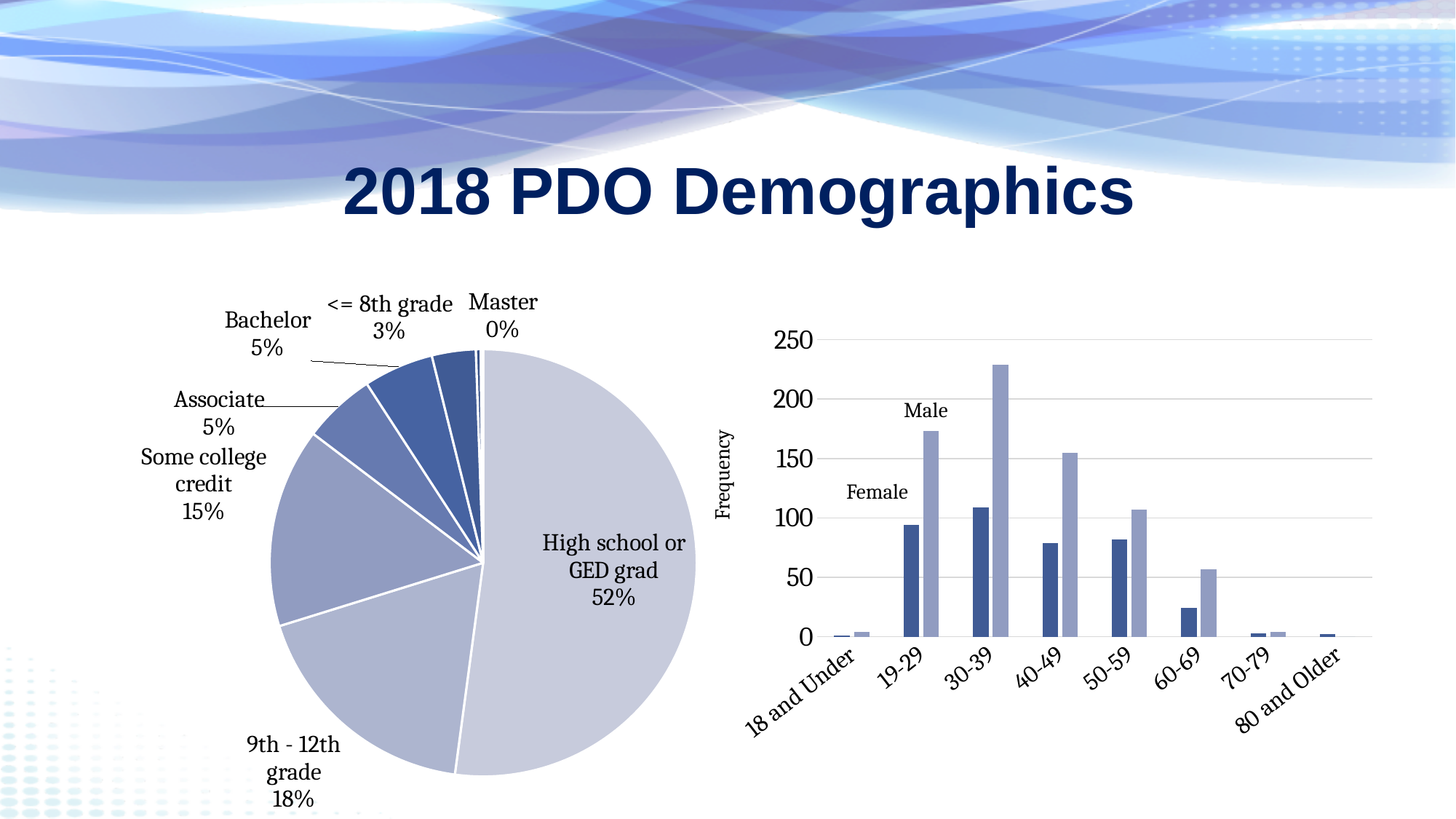
On the bar chart on the right, how many age groups are shown on the x axis? 8 On the bar chart on the right, is the Female value for 40-49 greater or less than 100? less On the pie chart on the left, what percentage is shown for 9th - 12th grade? 18% On the pie chart on the left, what share of the pie is High school or GED grad? 52% On the bar chart on the right, which age group has the tallest bar? 30-39 On the pie chart on the left, what percentage is shown for Some college credit? 15% On the pie chart on the left, how many slices are labelled? 7 On the bar chart on the right, for the 19-29 age group, which is larger, Male or Female? Male On the pie chart on the left, what is the difference in percentage points between 9th - 12th grade and Some college credit? 3 On the pie chart on the left, which category has the largest slice? High school or GED grad On the bar chart on the right, is the Male value for 30-39 greater or less than 200? greater